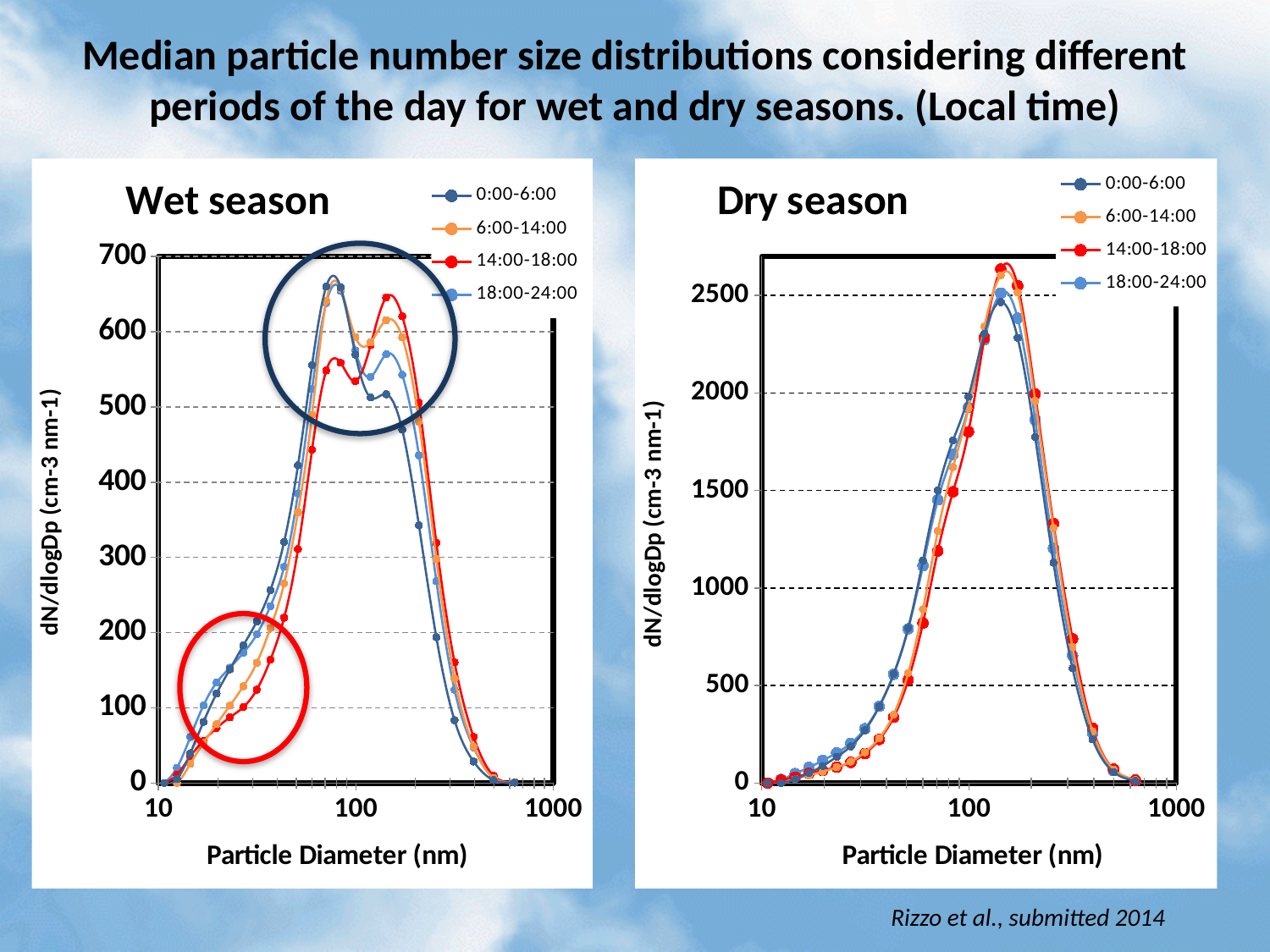
In the Dry season chart, do the values of the 6:00-14:00 series rise or fall as particle diameter increases from 10 nm to 100 nm? rise How many series does the legend of the Dry season chart list? 4 In the Wet season chart, is the peak value of the 0:00-6:00 series greater or less than 600? greater In the Wet season chart, at a particle diameter of 30 nm, which series has the larger value: 0:00-6:00 or 14:00-18:00? 0:00-6:00 In the Dry season chart, is the peak value of the 14:00-18:00 series greater or less than 2500? greater In the Wet season chart, is the peak value of the 14:00-18:00 series greater or less than 600? greater What is the highest tick value shown on the y axis of the Dry season chart? 2500 What is the label of the x axis on the Wet season chart? Particle Diameter (nm) In the Dry season chart, at a particle diameter of 30 nm, which series has the larger value: 18:00-24:00 or 14:00-18:00? 18:00-24:00 How many charts are shown on the slide? 2 What kind of chart is the Wet season chart? line chart